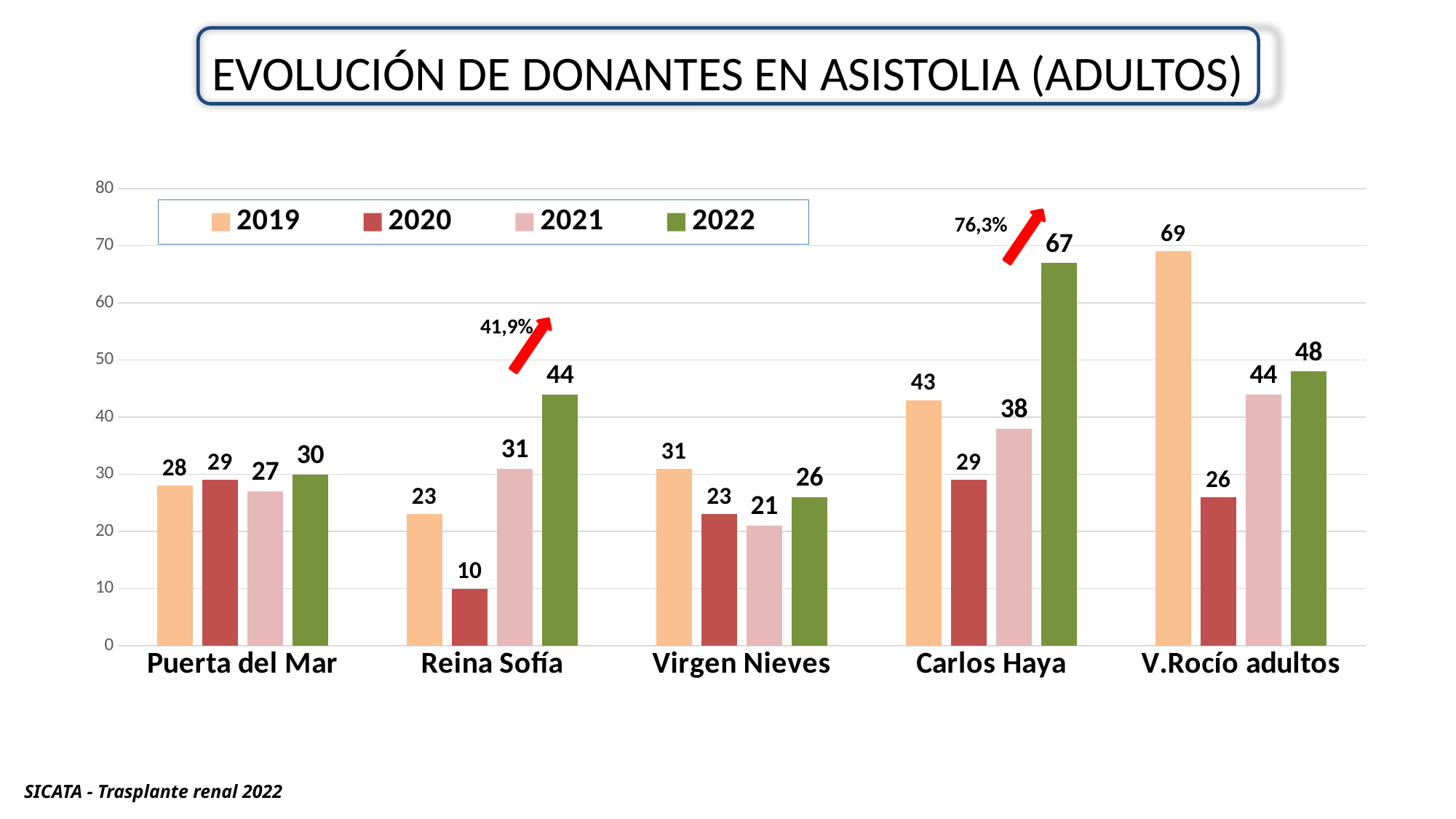
Do the values for Reina Sofía rise or fall from 2020 to 2022? rise What is the difference between the 2022 and 2021 values for Carlos Haya? 29 What is the title of the chart? EVOLUCIÓN DE DONANTES EN ASISTOLIA (ADULTOS) Which hospital has the lowest value in 2020? Reina Sofía What is the value for V.Rocío adultos in 2019? 69 What kind of chart is shown on the slide? bar chart Which hospital has the highest value in 2022? Carlos Haya What is the value for Carlos Haya in 2022? 67 How many hospitals are shown on the x axis? 5 Which is larger for Virgen Nieves: the 2019 value or the 2022 value? 2019 How many series does the legend list? 4 What is the value for Reina Sofía in 2020? 10